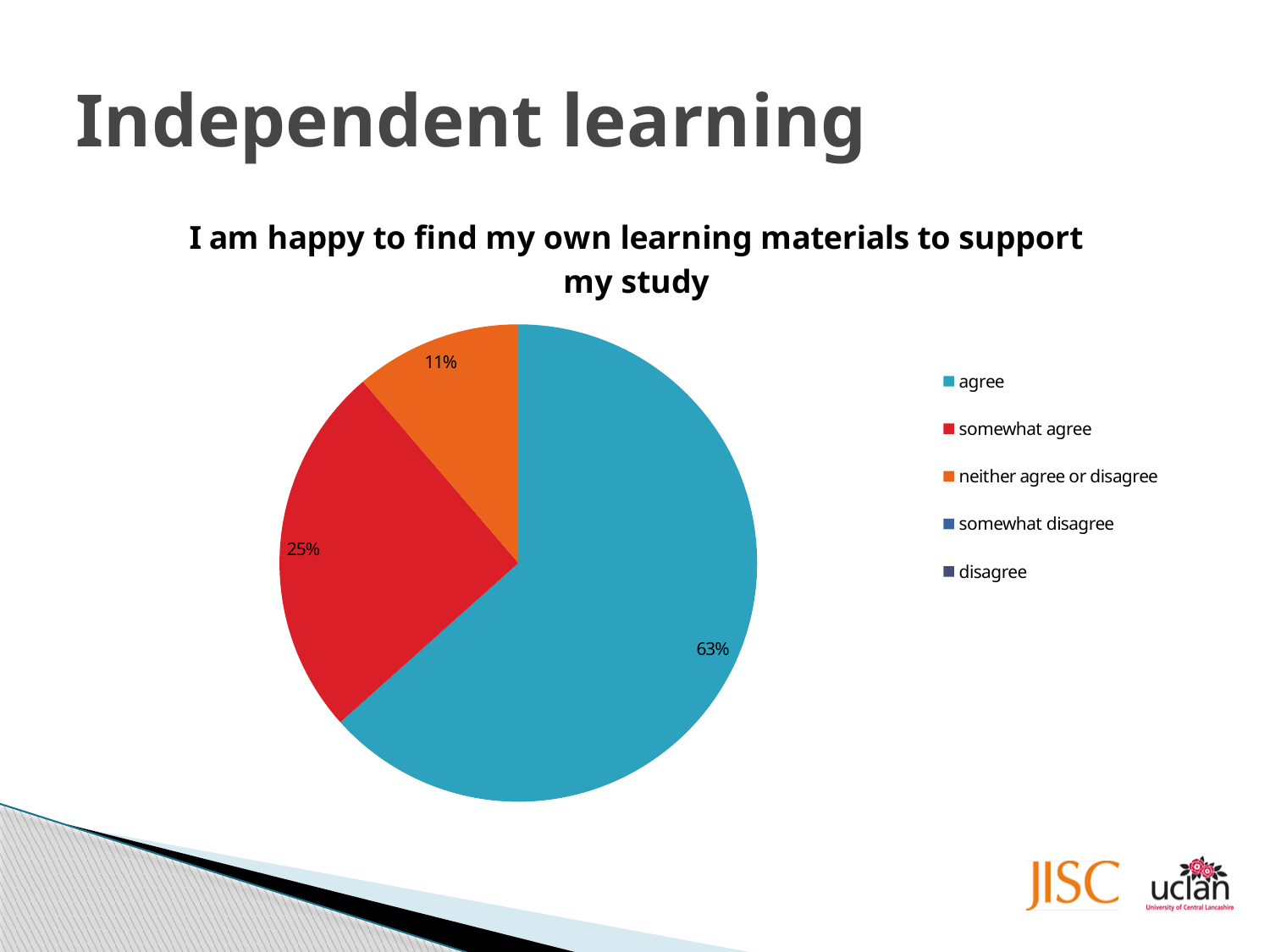
How many percentage points larger is the "agree" share than the "somewhat agree" share? 38 percentage points Which of the labelled slices has the smallest share of the pie? neither agree or disagree How many entries does the legend list? 5 Which is larger: the share for "somewhat agree" or the share for "neither agree or disagree"? somewhat agree What percentage of respondents chose "somewhat agree"? 25% What percentage of respondents chose "neither agree or disagree"? 11% What colour is the "agree" slice? Blue What percentage of respondents chose "agree"? 63% What is the title of the chart? I am happy to find my own learning materials to support my study Which response has the largest share of the pie? agree What kind of chart is shown on the slide? Pie chart How many slices with data labels are shown in the pie? 3